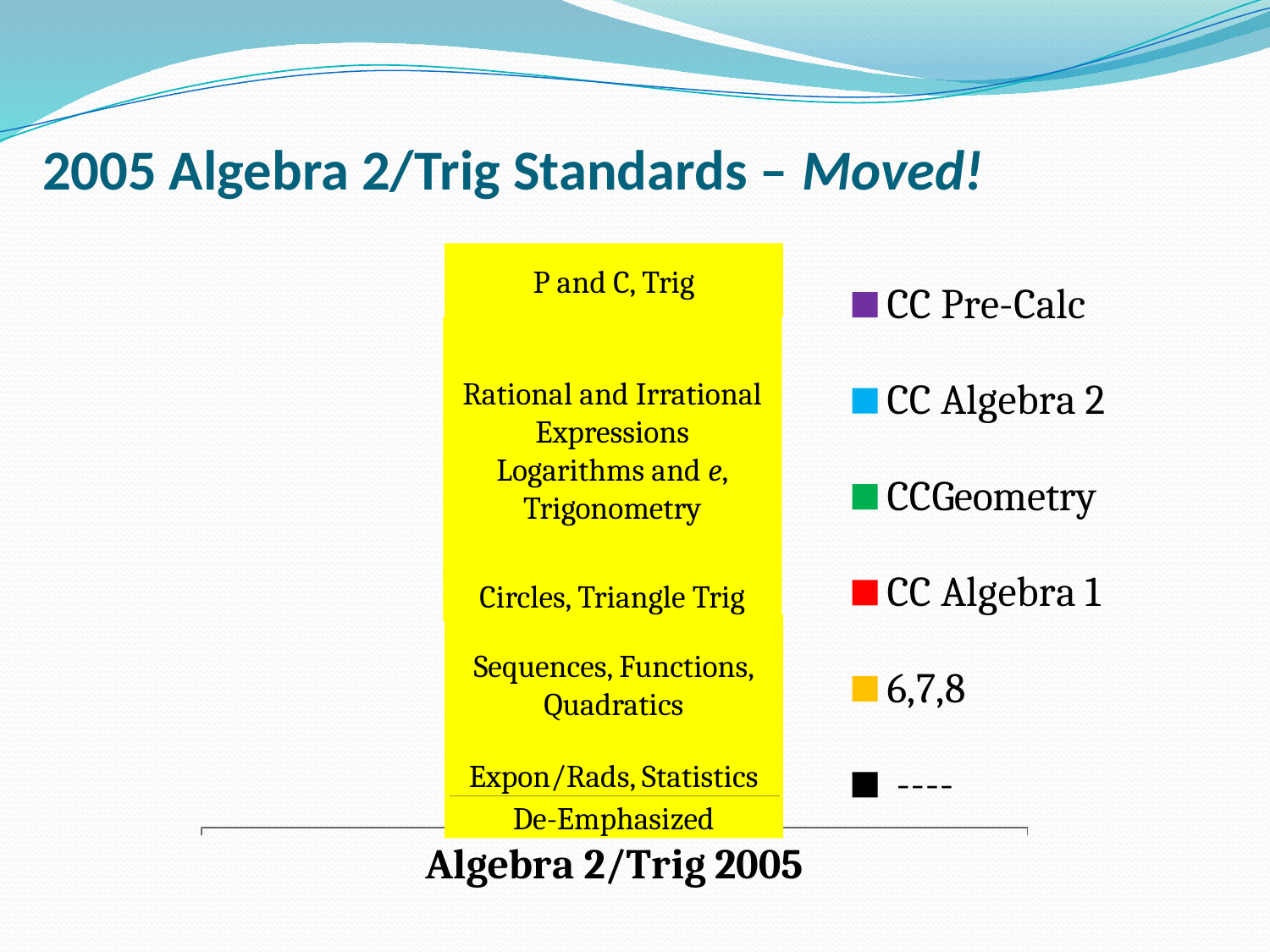
Which segment label in the bar mentions Statistics? Expon/Rads, Statistics What text label appears in the topmost segment of the stacked bar? P and C, Trig How many series does the chart's legend list? 6 What is the label of the single category on the x axis of the chart? Algebra 2/Trig 2005 How many categories are plotted along the x axis of the chart? 1 What kind of chart is shown on the slide? Stacked bar chart What text label appears in the bottom segment of the stacked bar? De-Emphasized Which legend entry is shown with a purple marker? CC Pre-Calc